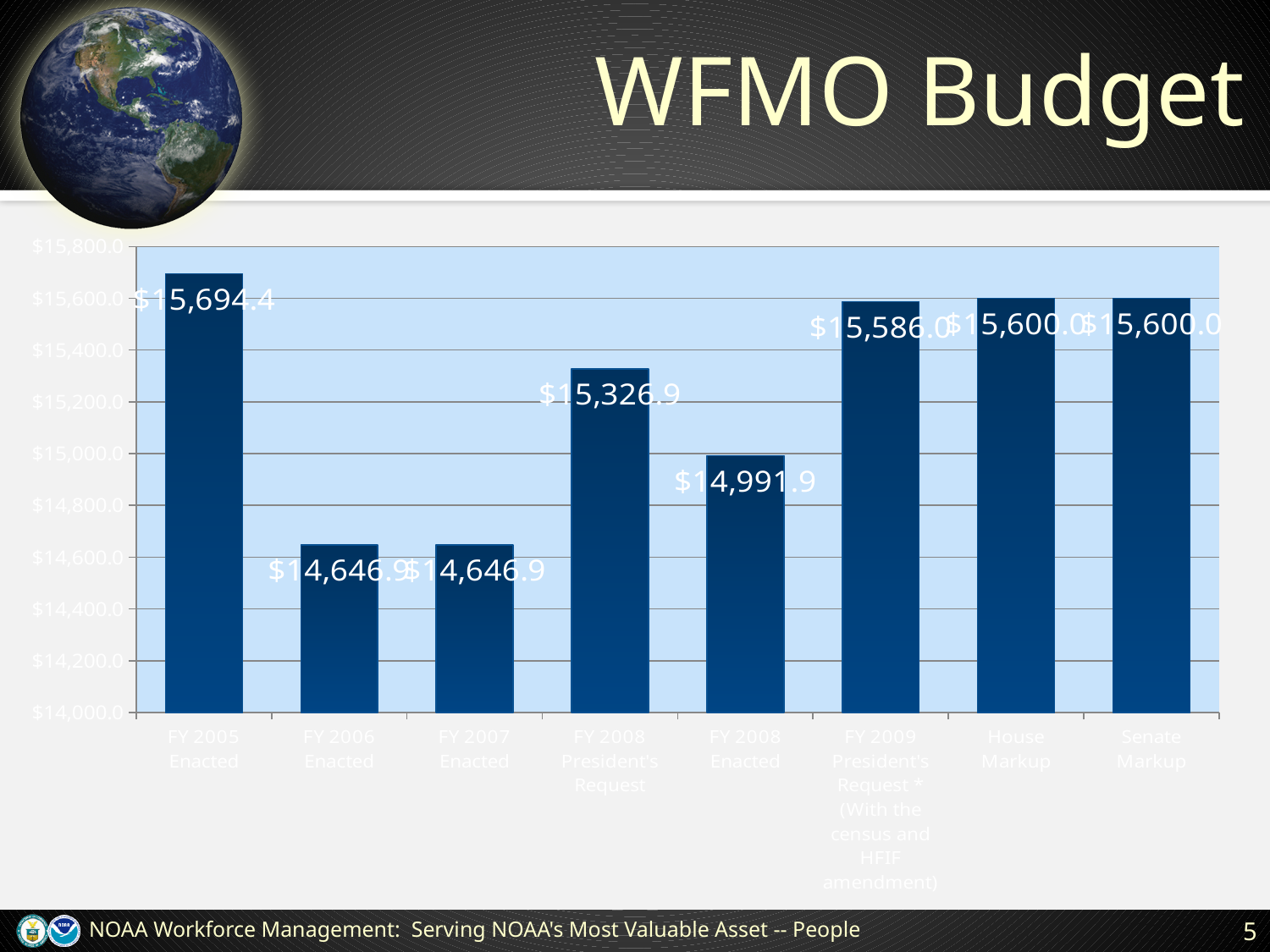
What is the difference between the House Markup value and the FY 2009 President's Request value? $14.0 What is the value for FY 2008 Enacted? $14,991.9 What is the value for House Markup? $15,600.0 What kind of chart is shown on the slide? bar chart What is the value for FY 2008 President's Request? $15,326.9 Which is larger, the value for FY 2008 President's Request or the value for FY 2008 Enacted? FY 2008 President's Request What is the difference between the FY 2005 Enacted value and the FY 2006 Enacted value? $1,047.5 How many bars are shown in the chart? 8 What is the title of the slide? WFMO Budget What is the value for FY 2005 Enacted? $15,694.4 Is the value for FY 2007 Enacted greater or less than $14,800.0? less Which category has the highest value? FY 2005 Enacted